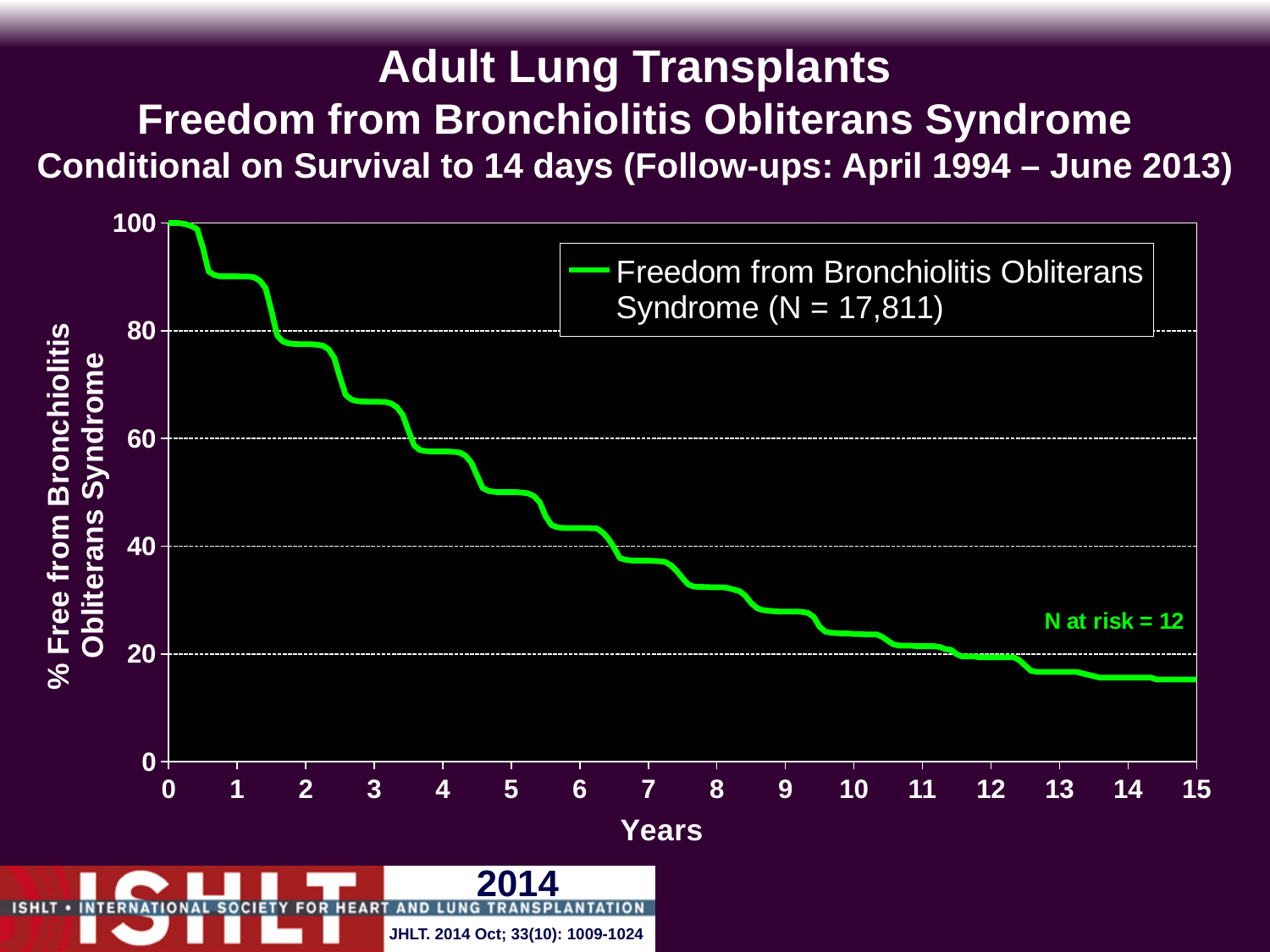
Is the value for year 3 greater or less than 60? greater What is the N given in the legend for the Freedom from Bronchiolitis Obliterans Syndrome series? 17,811 Does the percentage free from Bronchiolitis Obliterans Syndrome rise or fall as the years increase? fall Which is larger, the value at year 3 or the value at year 7? year 3 Is the value for year 15 greater or less than 20? less What kind of chart is shown on the slide? line chart How many series does the legend list? 1 What is the label of the x axis? Years What is the value of the curve at year 0? 100 Is the value for year 7 greater or less than 40? less What is the N at risk printed at the end of the curve? 12